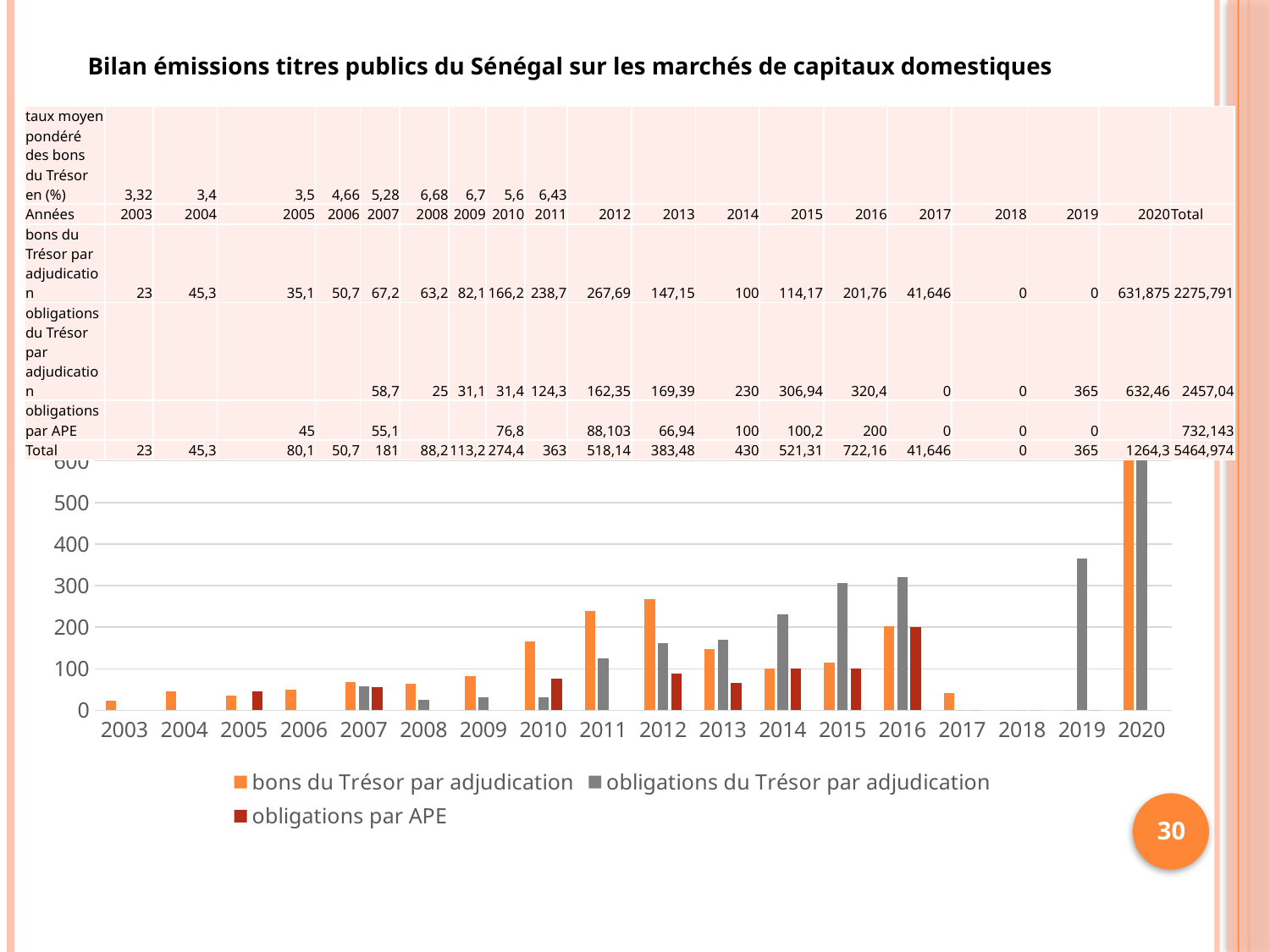
What kind of chart is shown on the slide? bar chart According to the table on the slide, what is the value of obligations par APE in 2016? 200 Is the value for obligations du Trésor par adjudication in 2019 greater or less than 300? greater According to the table on the slide, what is the value of bons du Trésor par adjudication in 2011? 238,7 How many years are shown along the x axis of the chart? 18 How many series does the chart legend list? 3 Do the obligations du Trésor par adjudication bars rise or fall from 2013 to 2016? rise In 2015, which is larger: bons du Trésor par adjudication or obligations du Trésor par adjudication? obligations du Trésor par adjudication Is the value for obligations par APE in 2010 greater or less than 100? less Is the value for bons du Trésor par adjudication in 2011 greater or less than 200? greater What is the title of the slide containing the chart? Bilan émissions titres publics du Sénégal sur les marchés de capitaux domestiques In which year is the bons du Trésor par adjudication bar the highest? 2020